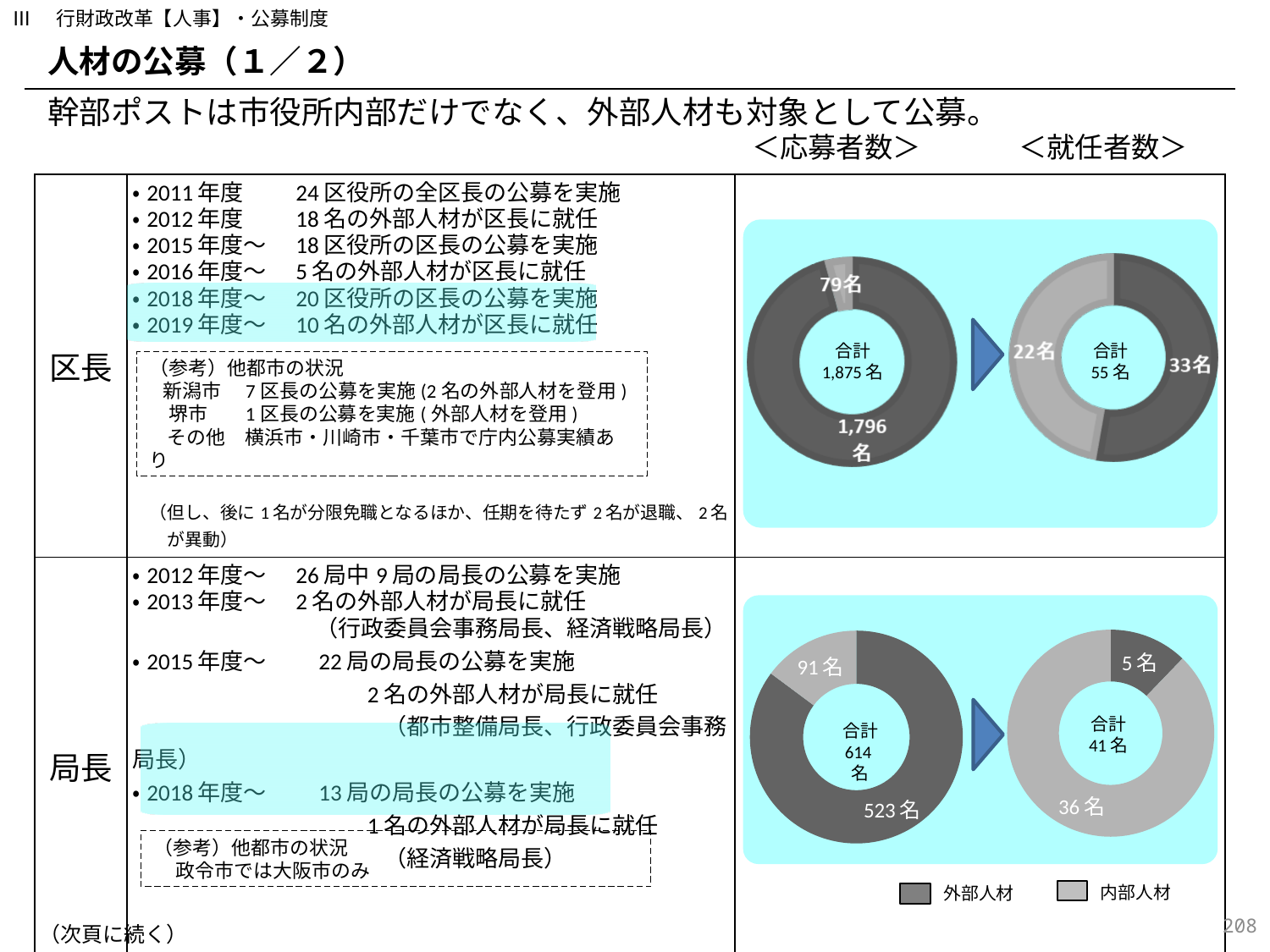
区長の＜就任者数＞のドーナツグラフで、外部人材と内部人材の就任者数の差は何名ですか？ 11名 区長の＜就任者数＞のドーナツグラフで、外部人材と内部人材ではどちらが多いですか？ 外部人材 局長の＜応募者数＞のドーナツグラフで、外部人材の応募者数は何名ですか？ 523名 局長の＜就任者数＞のドーナツグラフで、内部人材の就任者数は何名ですか？ 36名 区長の＜応募者数＞のドーナツグラフで、外部人材の応募者数は何名ですか？ 1,796名 局長の＜応募者数＞のドーナツグラフで、外部人材と内部人材の応募者数の差は何名ですか？ 432名 スライド右側のグラフはどの種類のグラフですか？ ドーナツグラフ 区長の＜就任者数＞のドーナツグラフで、外部人材の就任者数は何名ですか？ 33名 区長の＜応募者数＞のドーナツグラフで、合計は何名ですか？ 1,875名 区長の＜応募者数＞のドーナツグラフで、内部人材の応募者数は何名ですか？ 79名 局長の＜応募者数＞のドーナツグラフで、合計は何名ですか？ 614名 局長の＜就任者数＞のドーナツグラフで、外部人材と内部人材ではどちらが多いですか？ 内部人材